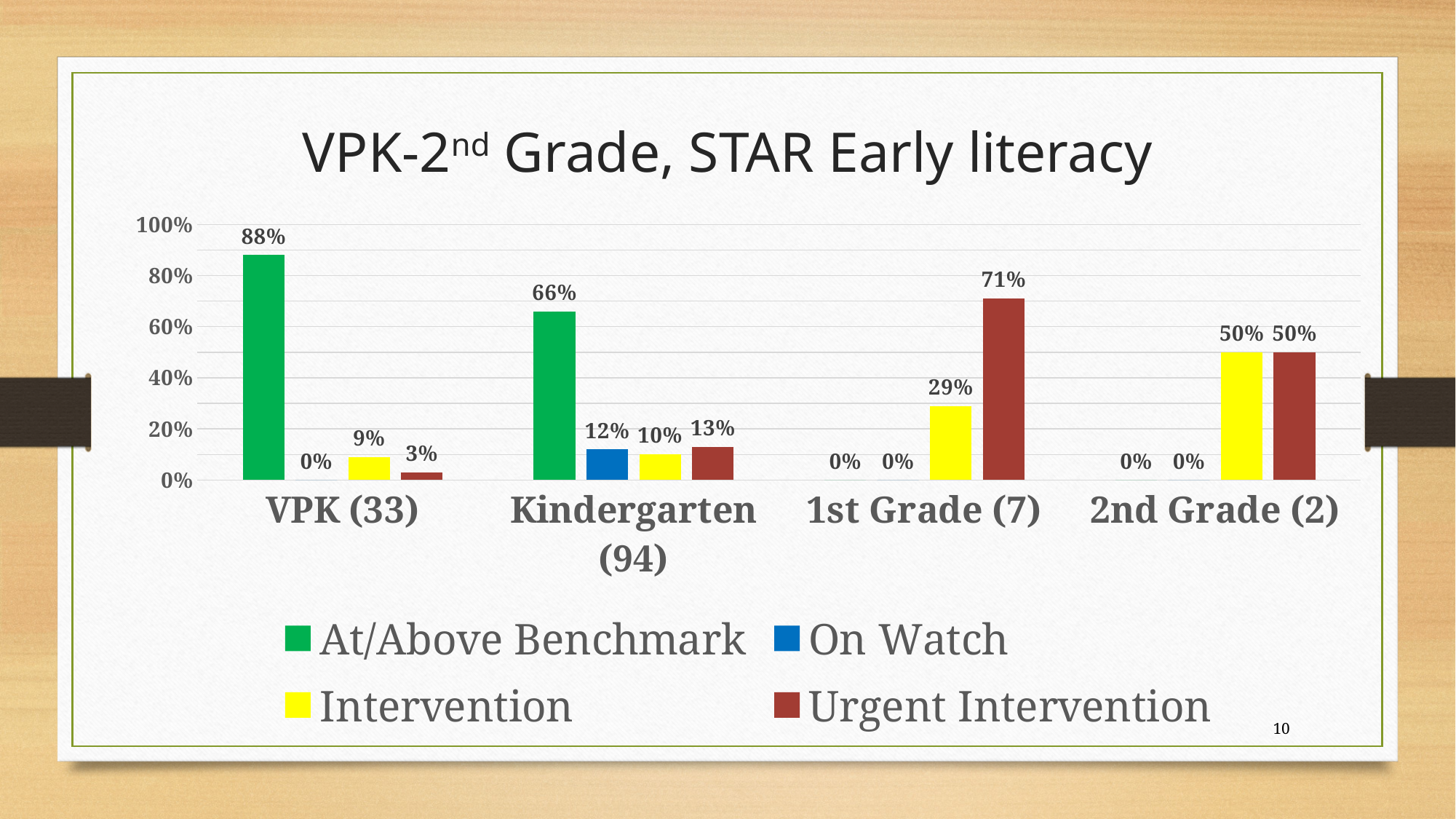
What is the Intervention value for 2nd Grade (2)? 50% What colour represents the Intervention series? Yellow What is the Urgent Intervention value for 1st Grade (7)? 71% Which is larger for Kindergarten (94): the Intervention value or the Urgent Intervention value? Urgent Intervention How many grade groups are shown on the x axis? 4 Which grade group has the highest Urgent Intervention percentage? 1st Grade (7) What kind of chart is shown on the slide? Bar chart What is the difference between the At/Above Benchmark values for VPK (33) and Kindergarten (94)? 22% Which grade group has the highest At/Above Benchmark percentage? VPK (33) How many series does the legend list? 4 What percentage of VPK (33) students are At/Above Benchmark? 88% What is the On Watch value for Kindergarten (94)? 12%